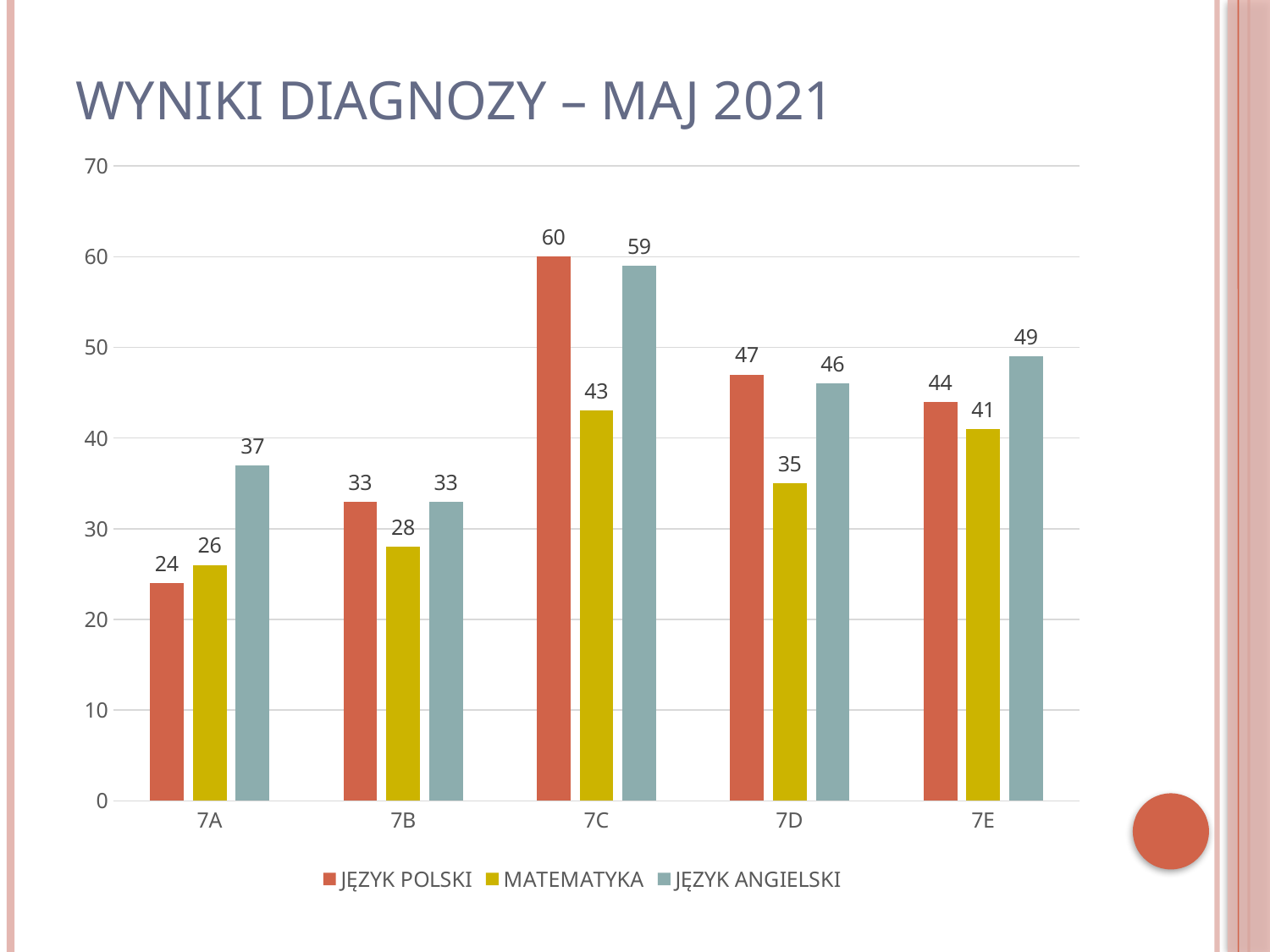
Which class has the highest JĘZYK POLSKI value? 7C Is the MATEMATYKA value for class 7E greater or less than 40? greater What is the title of the chart? WYNIKI DIAGNOZY – MAJ 2021 What is the JĘZYK ANGIELSKI value for class 7E? 49 What is the difference between the JĘZYK POLSKI and MATEMATYKA values for class 7C? 17 Which is larger for class 7D: the JĘZYK POLSKI value or the JĘZYK ANGIELSKI value? JĘZYK POLSKI What is the JĘZYK POLSKI value for class 7C? 60 Which class has the lowest MATEMATYKA value? 7A What kind of chart is shown on the slide? bar chart How many classes are shown on the x axis? 5 What is the MATEMATYKA value for class 7B? 28 How many series does the legend list? 3